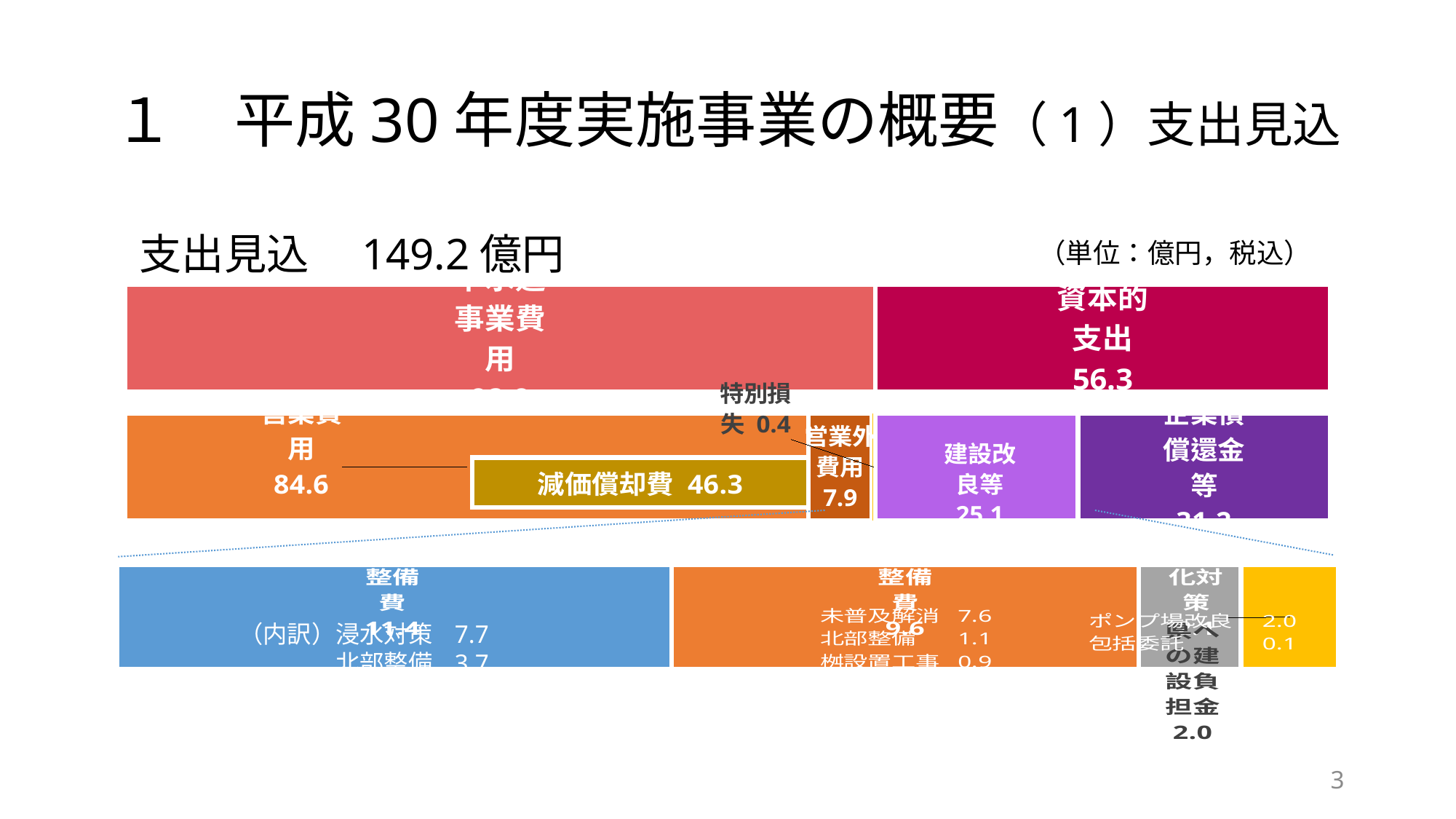
What is the value for 企業債償還金等? 31.2 What kind of chart is shown on the slide? bar chart What is the value for 浸水対策 in the breakdown at the bottom? 7.7 What is the difference between 営業費用 and 営業外費用? 76.7 What is the value for 営業費用? 84.6 What is the value for 減価償却費? 46.3 What is the value for 資本的支出? 56.3 Which is larger, 営業費用 or 資本的支出? 営業費用 What is the value for 特別損失? 0.4 What is the value for 営業外費用? 7.9 What is the total expenditure forecast (支出見込) shown on the slide? 149.2 億円 What is the value for 建設改良等? 25.1